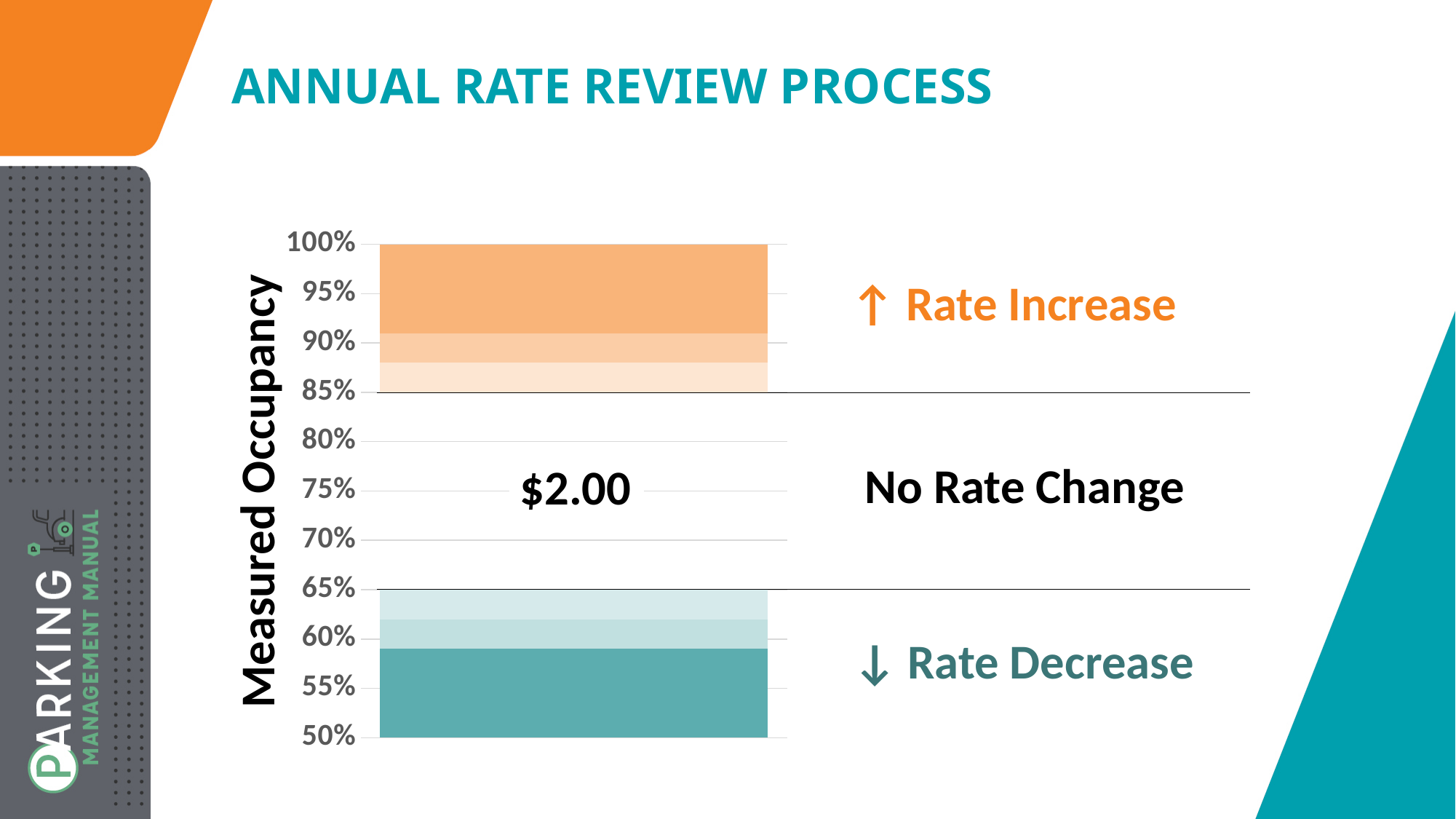
Is the upper boundary of the Rate Decrease zone greater or less than 70%? less How wide is the No Rate Change zone, from its lower boundary of 65% to its upper boundary of 85%? 20% What is the lowest value shown on the y axis? 50% At what measured occupancy does the Rate Decrease zone end (its upper boundary)? 65% At what measured occupancy does the Rate Increase zone begin? 85% What is the highest value shown on the y axis? 100% What kind of chart is shown on the slide? bar chart What rate is shown in the No Rate Change zone? $2.00 Which colour is used for the Rate Increase zone on the chart? orange Is the lower boundary of the Rate Increase zone greater or less than 80%? greater How many rate outcome zones are shown on the chart? 3 What is the title of the y axis on the chart? Measured Occupancy